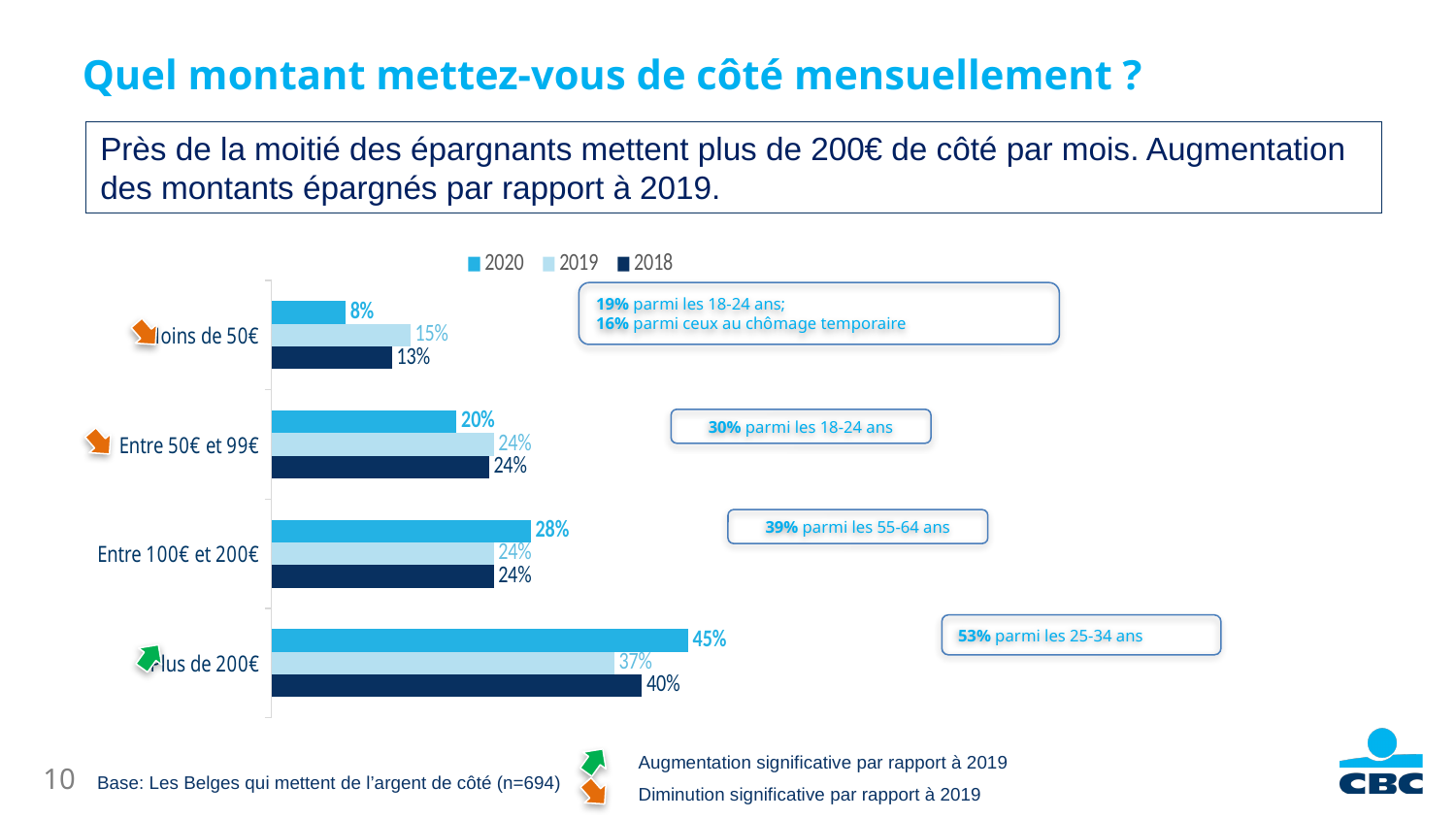
How many series does the legend list? 3 How many categories are shown on the chart? 4 Which category has the lowest 2020 value? Moins de 50€ What kind of chart is shown on the slide? Bar chart What is the difference between the 2020 and 2019 values for 'Plus de 200€'? 8 percentage points Which years are listed in the chart legend? 2020, 2019, 2018 What is the 2018 value for 'Entre 50€ et 99€'? 24% What is the 2019 value for 'Moins de 50€'? 15% What is the 2020 value for 'Plus de 200€'? 45% Which category has the highest 2020 value? Plus de 200€ For 'Moins de 50€', which is larger: the 2019 value or the 2018 value? 2019 What is the 2020 value for 'Entre 100€ et 200€'? 28%